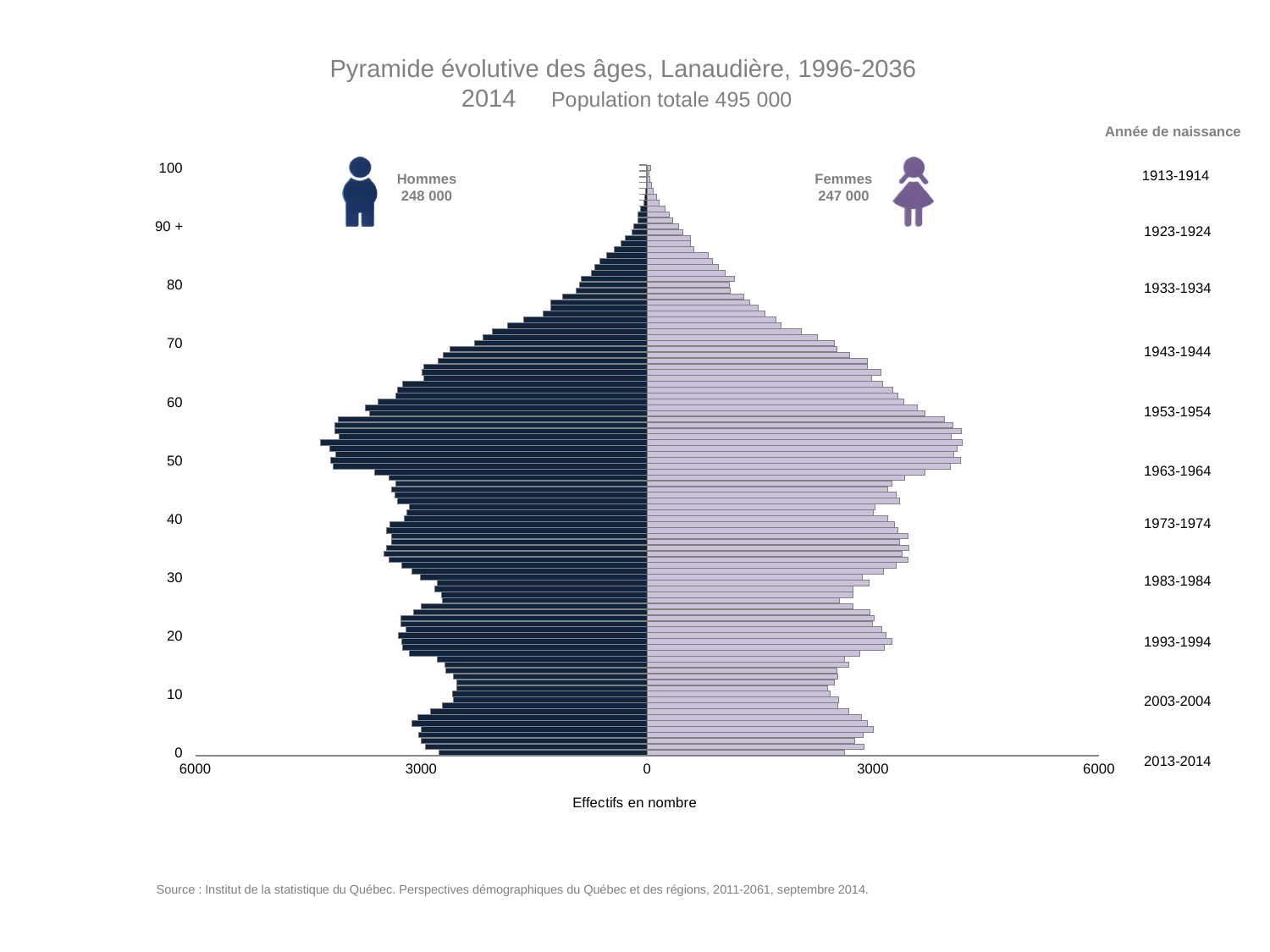
What is the difference between the number of Hommes and the number of Femmes? 1 000 Do the bar lengths rise or fall as age increases from 60 to 100? fall Is the value for Hommes at around age 53 greater or less than 3000? greater What is the number of Femmes shown on the chart? 247 000 What is the number of Hommes shown on the chart? 248 000 Is the value for Femmes at around age 90 greater or less than 3000? less What is the label of the horizontal axis? Effectifs en nombre What is the total population shown for 2014? 495 000 What kind of chart is shown on the slide? Bar chart (population pyramid) How many population groups (sexes) are plotted on the chart? 2 Is the value for Hommes at around age 10 greater or less than 3000? less Which group is larger, Hommes or Femmes? Hommes